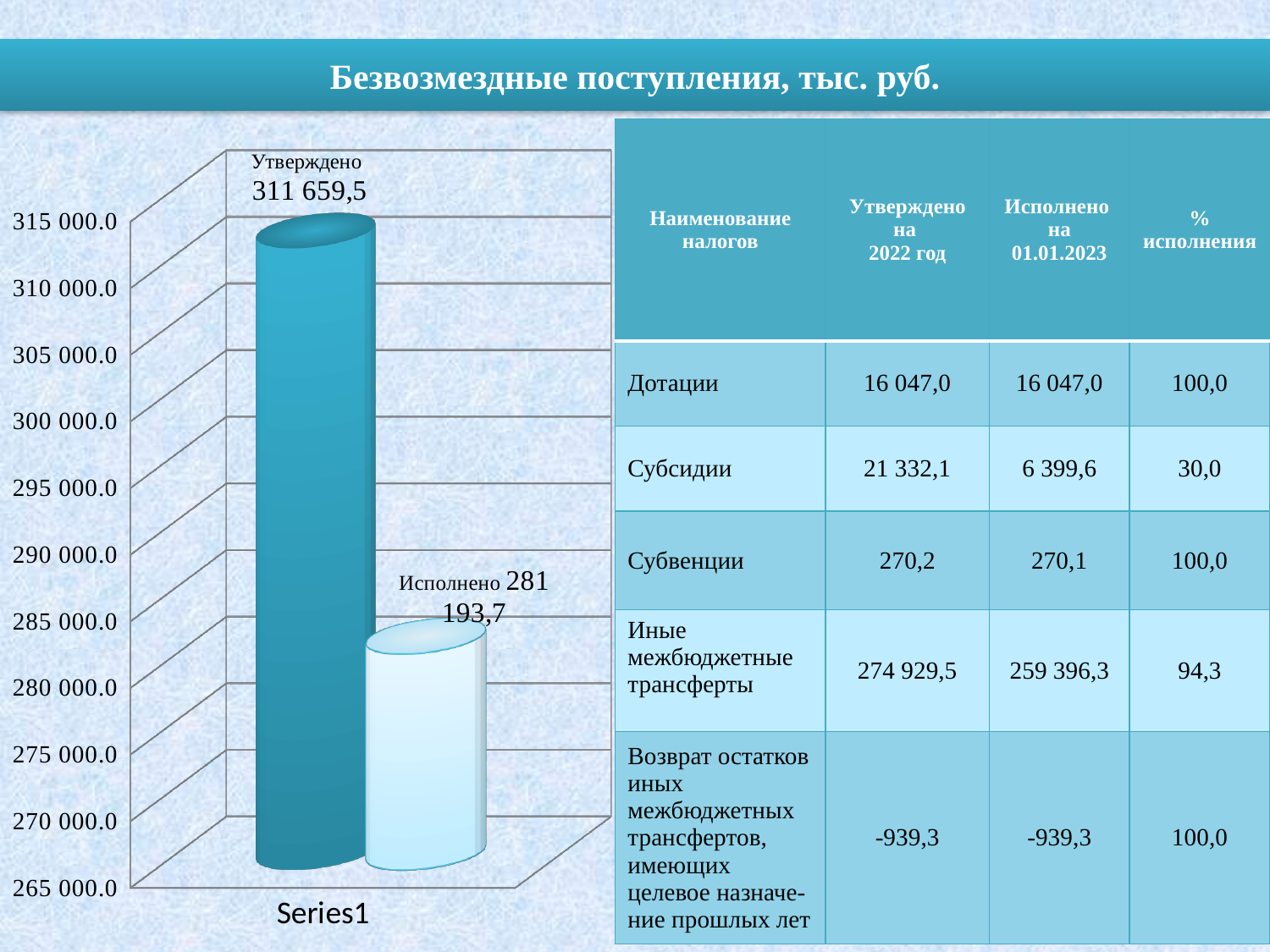
Which is larger in the chart, Утверждено or Исполнено? Утверждено What kind of chart is shown on the left of the slide? bar chart Is the value of the Исполнено bar greater or less than 285 000.0? less Which bar in the chart is the shortest? Исполнено What is the difference between the Утверждено and Исполнено values in the chart? 30 465,8 What category label appears under the bars on the chart's horizontal axis? Series1 What is the lowest value shown on the chart's vertical axis? 265 000.0 What is the value of the Исполнено bar in the chart? 281 193,7 What is the value of the Утверждено bar in the chart? 311 659,5 Which bar in the chart is the tallest? Утверждено How many bars are plotted in the chart? 2 Is the value of the Утверждено bar greater or less than 305 000.0? greater